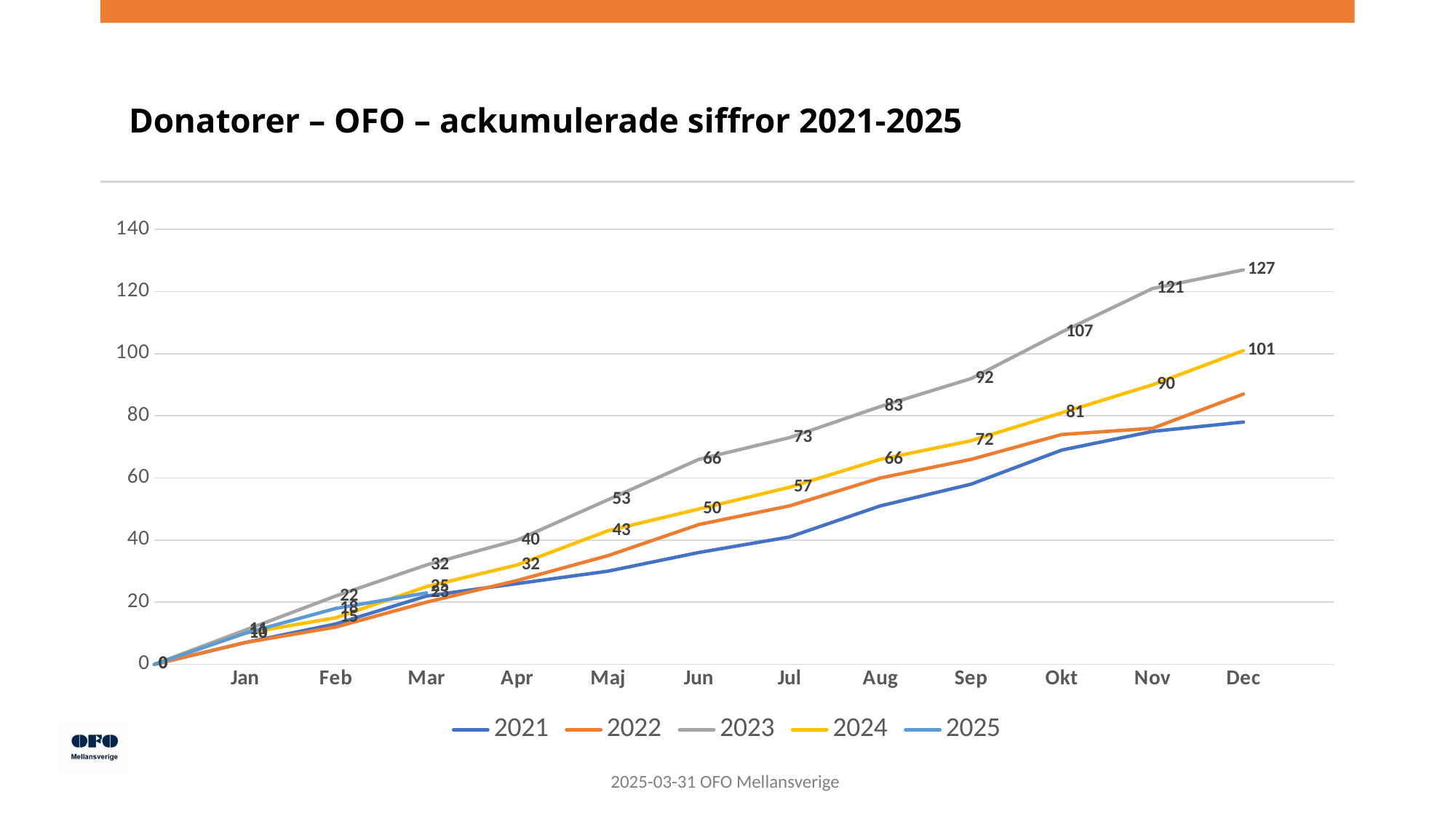
What is the value for 2024 in Jul? 57 How many series does the legend list? 5 By how much does the 2023 value increase from Okt to Nov? 14 Does the 2023 series rise or fall from Jan to Dec? rise What is the title of the chart? Donatorer – OFO – ackumulerade siffror 2021-2025 What is the value for 2023 in Dec? 127 What is the difference between the 2023 and 2024 values in Dec? 26 What kind of chart is shown on the slide? line chart Is the value for 2022 in Dec greater or less than 80? greater What is the value for 2023 in Okt? 107 What is the value for 2024 in Dec? 101 Which series has the highest value in Dec? 2023